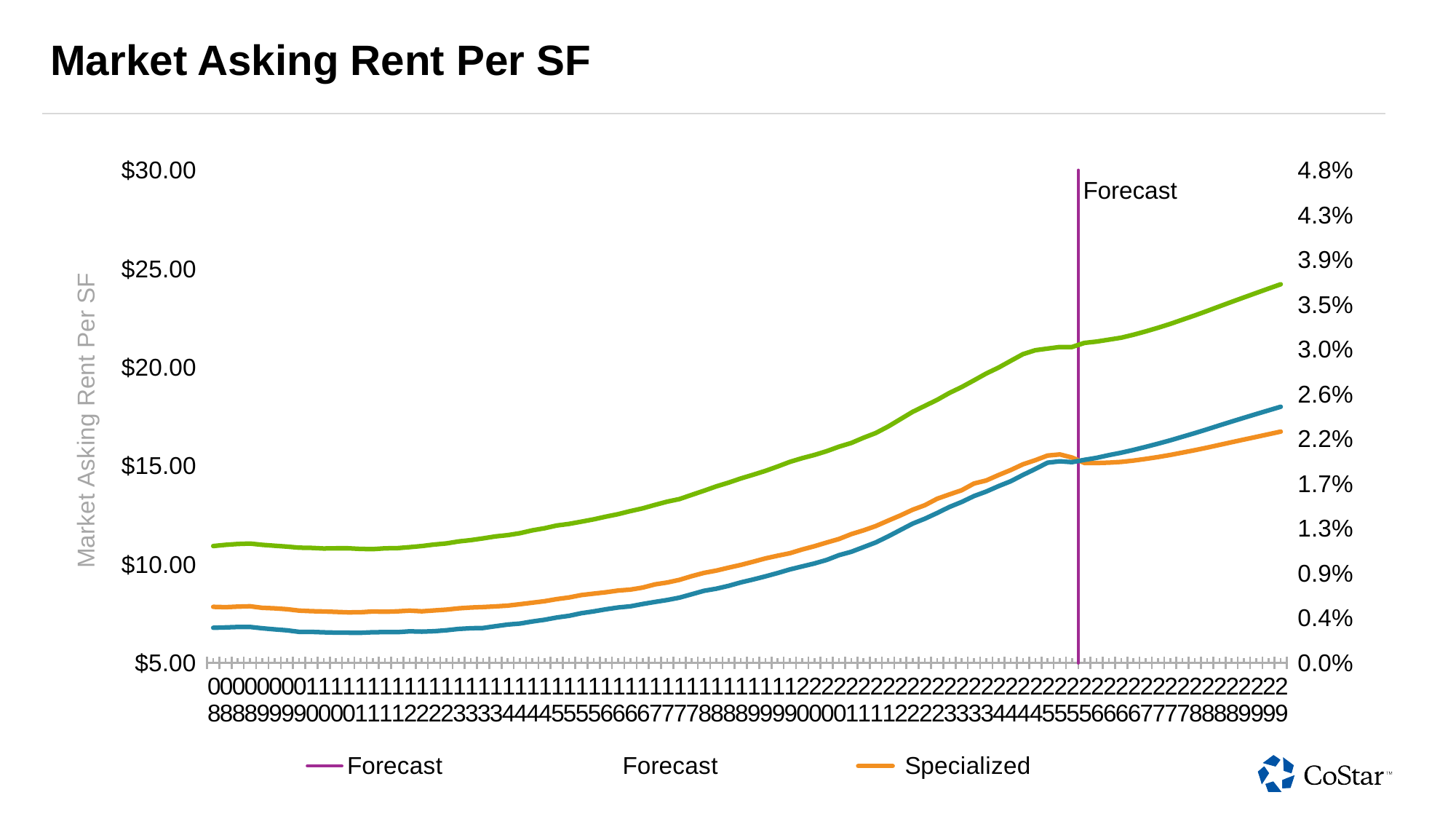
What label is printed next to the vertical purple line on the chart? Forecast What is the title of the chart? Market Asking Rent Per SF Is the value of the blue line at the left end of the chart greater or less than $10.00? less At the right end of the chart, which line is lower: the blue line or the orange Specialized line? the orange Specialized line Is the value of the green line at the left end of the chart greater or less than $15.00? less Does the orange Specialized line generally rise or fall from left to right across the chart? rise Is the value of the green line at the right end of the chart greater or less than $20.00? greater What kind of chart is shown on the slide? line chart How many entries does the chart legend list? 3 At the right end of the chart, which line is higher: the green line or the orange Specialized line? the green line